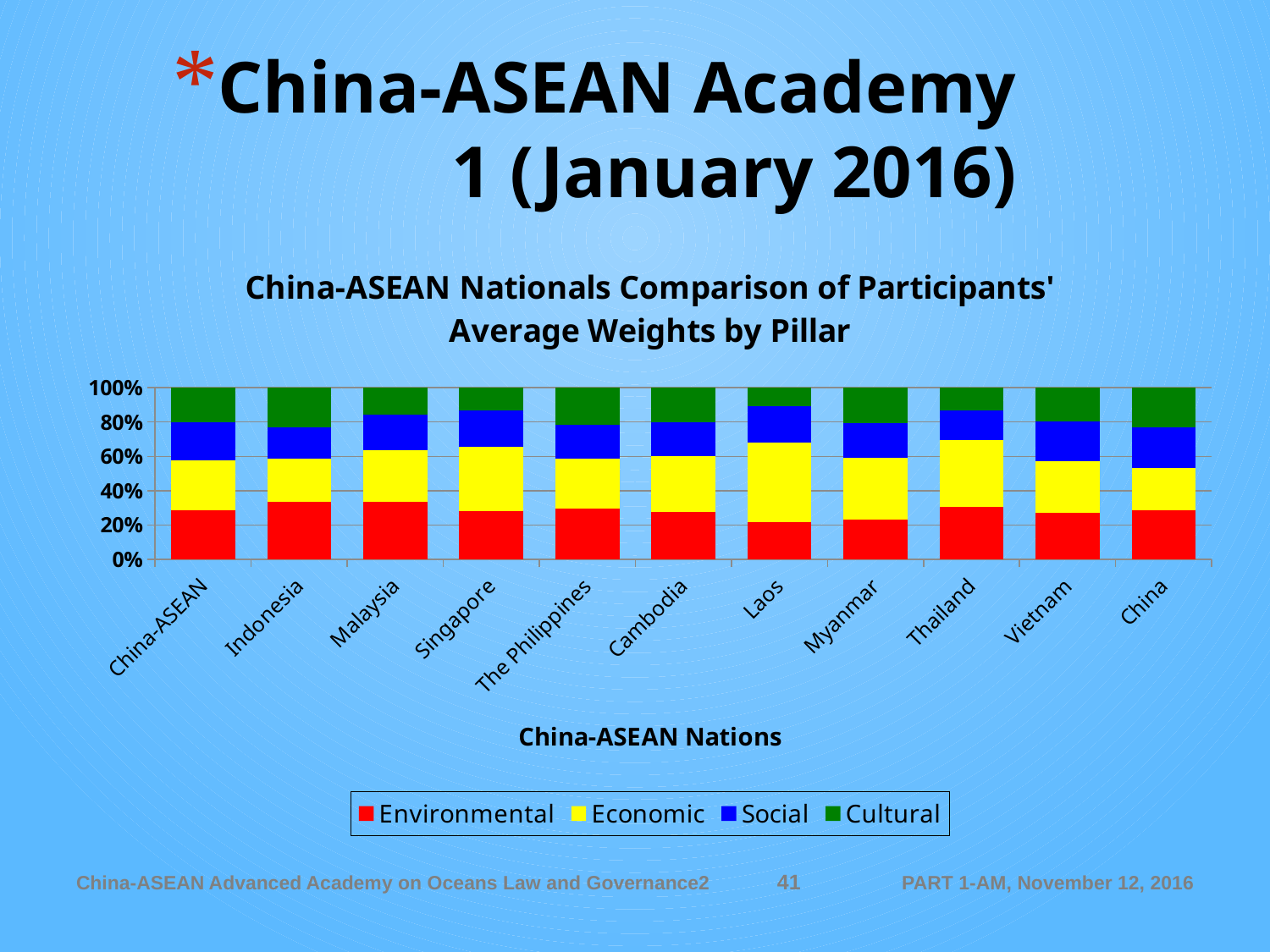
Is the Environmental value for Laos greater or less than 40%? less Which is larger, the Environmental value for Indonesia or the Environmental value for Laos? Indonesia Which nation has the largest Economic share in the chart? Laos Is the Environmental value for Indonesia greater or less than 20%? greater How many series does the chart's legend list? 4 What is the title of the chart's x axis? China-ASEAN Nations What is the total height of each stacked bar in the chart? 100% How many nations (categories) are shown along the x axis of the chart? 11 Is the Cultural value for Laos greater or less than 20%? less Which colour represents the Economic series in the chart's legend? Yellow What kind of chart is shown on the slide? Stacked bar chart Which nation has the smallest Cultural share in the chart? Laos